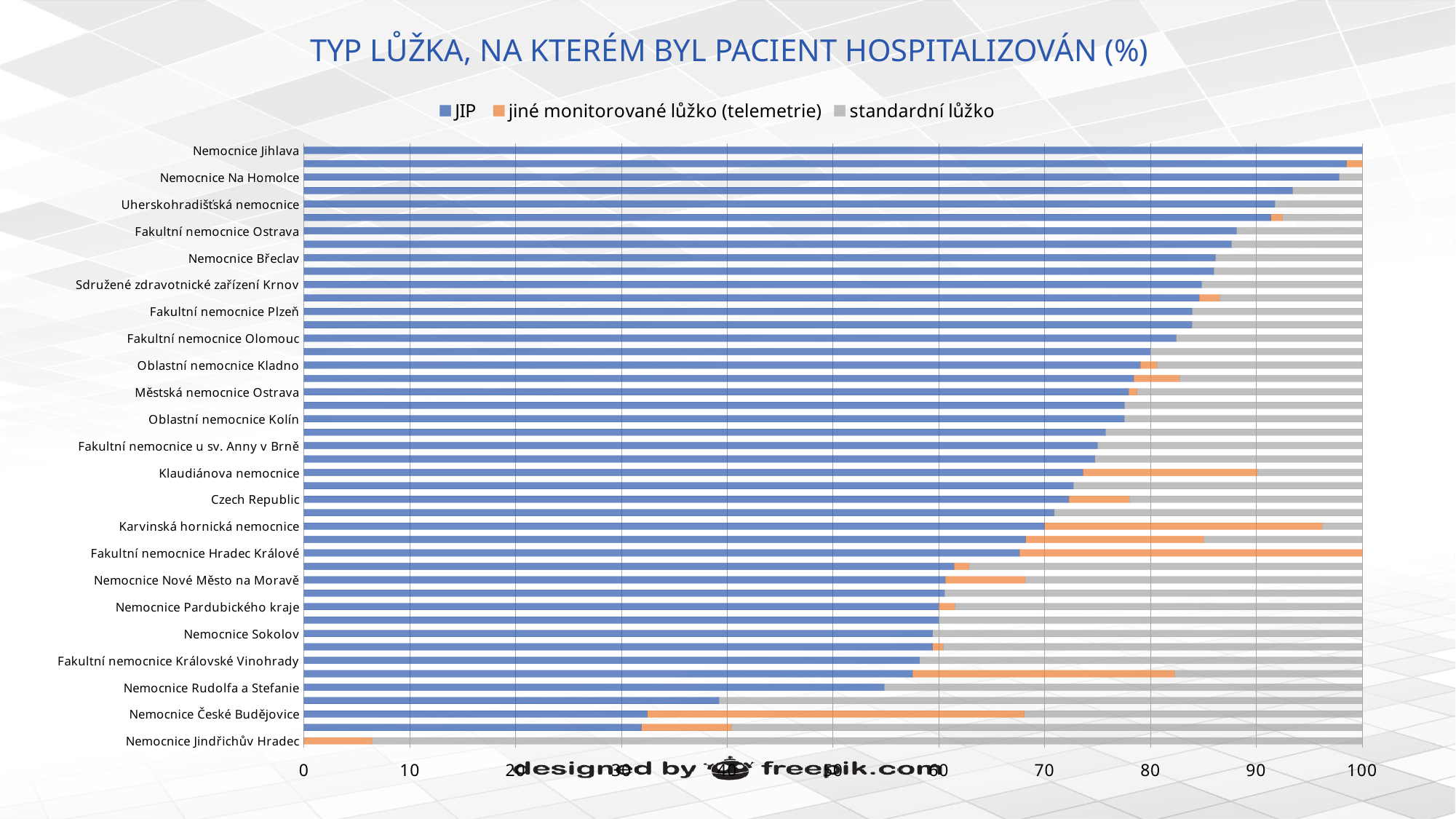
Do the JIP values rise or fall going from the top of the chart to the bottom? fall Which has the larger JIP share, Fakultní nemocnice Ostrava or Nemocnice České Budějovice? Fakultní nemocnice Ostrava What are the three series named in the legend? JIP, jiné monitorované lůžko (telemetrie), standardní lůžko What kind of chart is shown on the slide? Stacked bar chart How many series does the legend list? 3 Is the JIP value for Nemocnice České Budějovice greater or less than 40? less Is the JIP value for Fakultní nemocnice Ostrava greater or less than 80? greater Which labelled hospital has the highest JIP share? Nemocnice Jihlava Is the JIP value for Nemocnice Jihlava greater or less than 90? greater What is the title of the chart? TYP LŮŽKA, NA KTERÉM BYL PACIENT HOSPITALIZOVÁN (%) Which labelled hospital has the lowest JIP share? Nemocnice Jindřichův Hradec